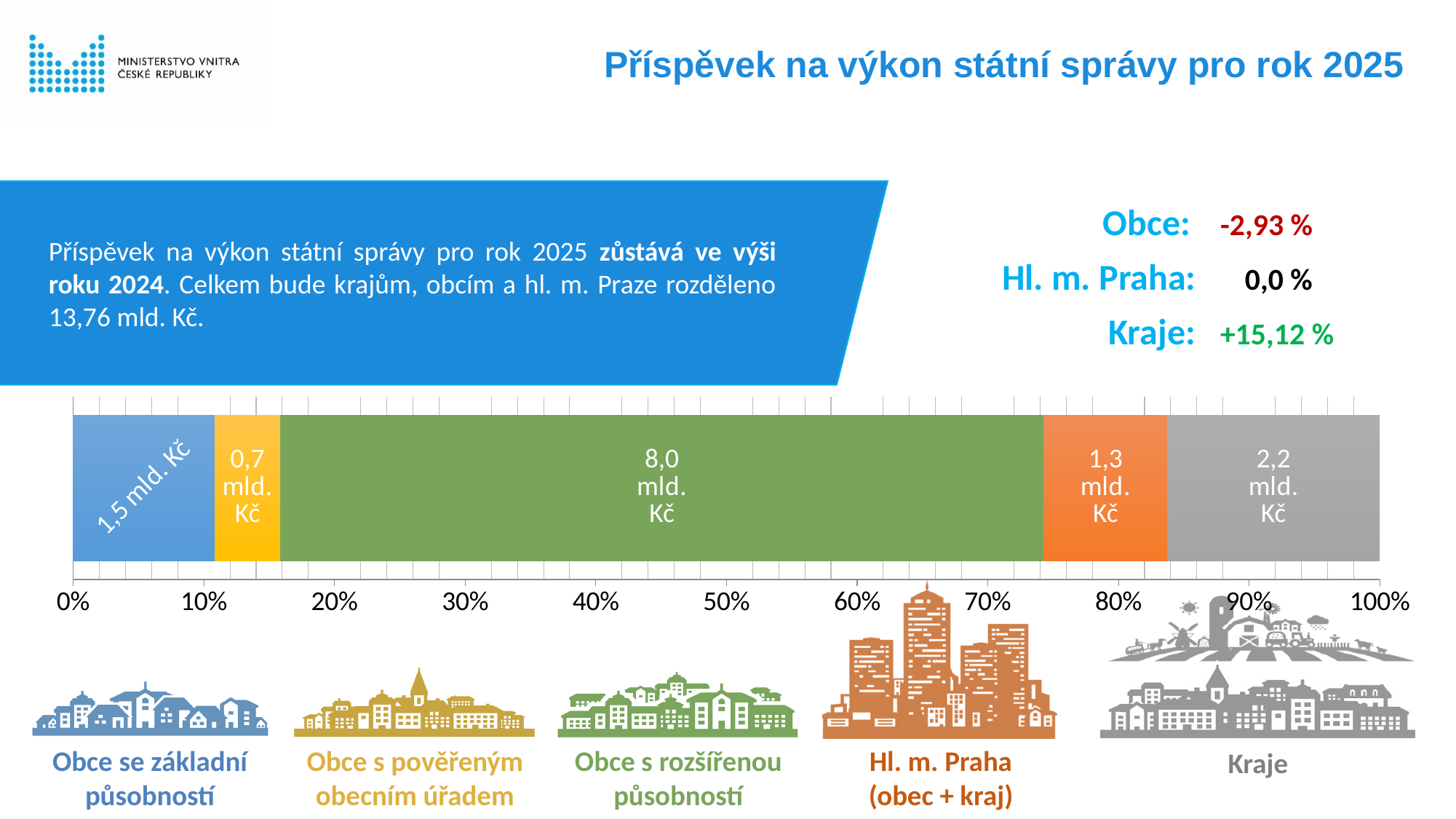
Which is larger, the value for Kraje or the value for Obce se základní působností? Kraje Which segment of the bar has the smallest value? Obce s pověřeným obecním úřadem What colour is the Kraje segment of the bar? grey What is the difference between the Obce s rozšířenou působností value and the Kraje value? 5,8 mld. Kč What value is shown for the Obce s pověřeným obecním úřadem segment? 0,7 mld. Kč How many segments make up the stacked bar? 5 Is the cumulative share at the right end of the Obce s rozšířenou působností segment greater or less than 70%? greater What kind of chart is shown on the slide? stacked bar chart What value is shown for the Hl. m. Praha (obec + kraj) segment? 1,3 mld. Kč What value is shown for the Kraje segment of the bar? 2,2 mld. Kč Which segment of the bar has the largest value? Obce s rozšířenou působností What value is shown for the Obce s rozšířenou působností segment of the bar? 8,0 mld. Kč